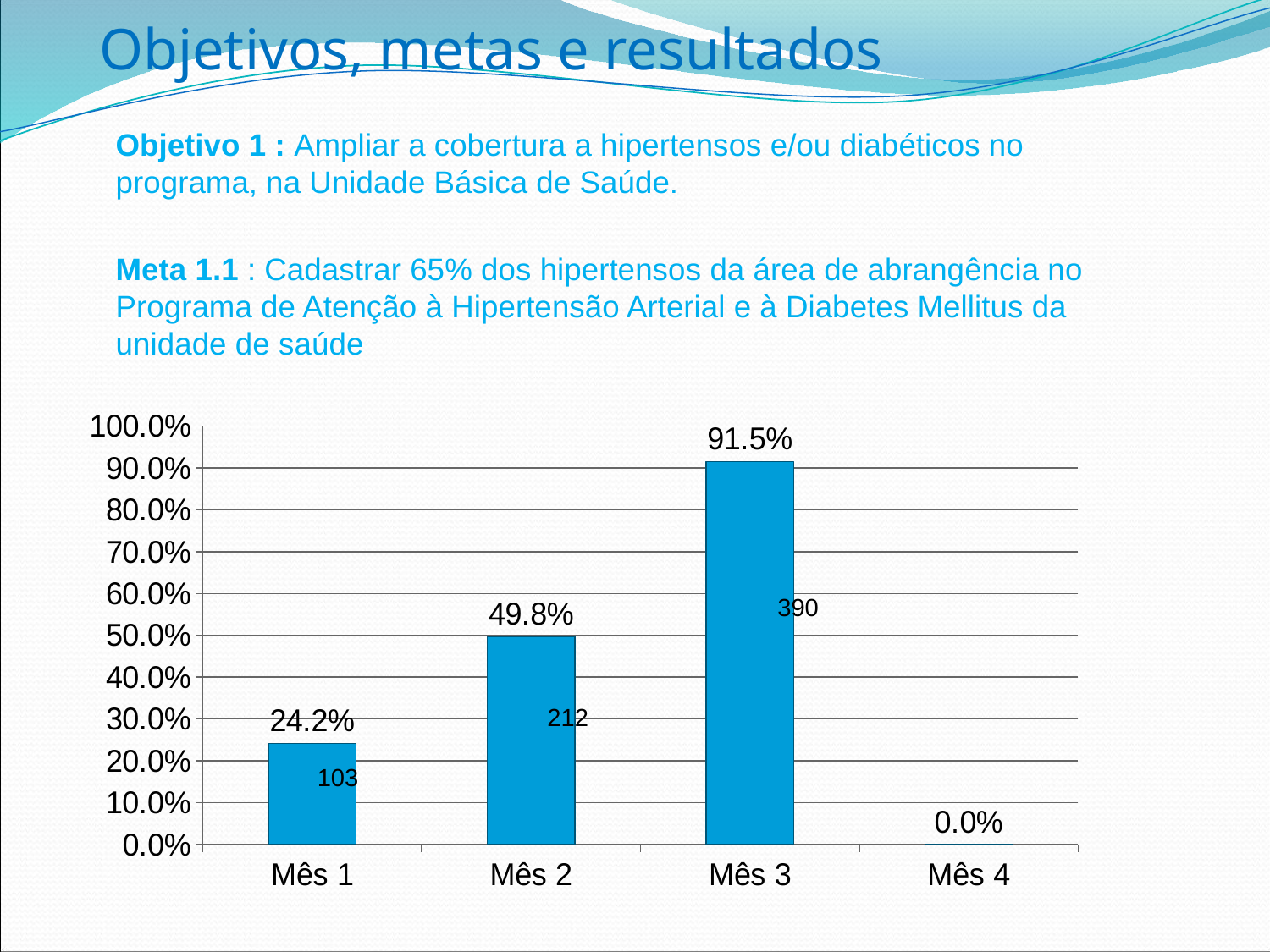
How many months are shown on the x axis? 4 What is the value for Mês 1? 24.2% What number is printed inside the bar for Mês 1? 103 What number is printed inside the bar for Mês 3? 390 What is the value for Mês 2? 49.8% What is the difference between the values for Mês 3 and Mês 2? 41.7% Which is larger, the value for Mês 1 or the value for Mês 2? Mês 2 Which month has the lowest value? Mês 4 Which month has the highest value? Mês 3 What is the value for Mês 3? 91.5% What kind of chart is shown on the slide? Bar chart What is the value for Mês 4? 0.0%